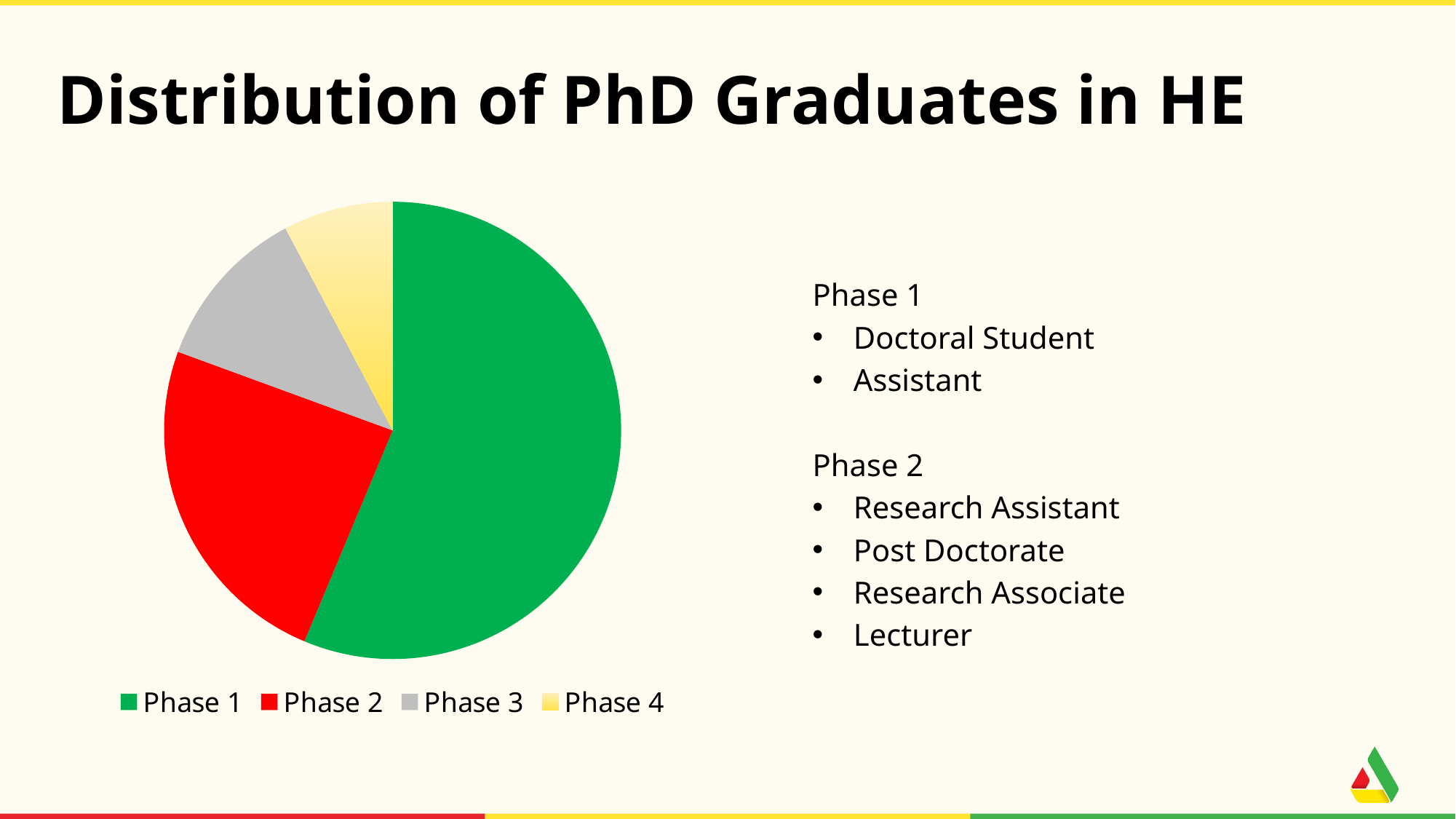
Which slice is larger, Phase 2 or Phase 3? Phase 2 Which phase has the largest slice of the pie chart? Phase 1 How many slices does the pie chart have? 4 Which slice is larger, Phase 1 or Phase 2? Phase 1 Which slice is larger, Phase 3 or Phase 4? Phase 3 What is the title of the slide containing the pie chart? Distribution of PhD Graduates in HE What colour represents Phase 2 in the pie chart? red What kind of chart is shown on the slide? pie chart Which phase has the smallest slice of the pie chart? Phase 4 How many entries does the legend of the pie chart list? 4